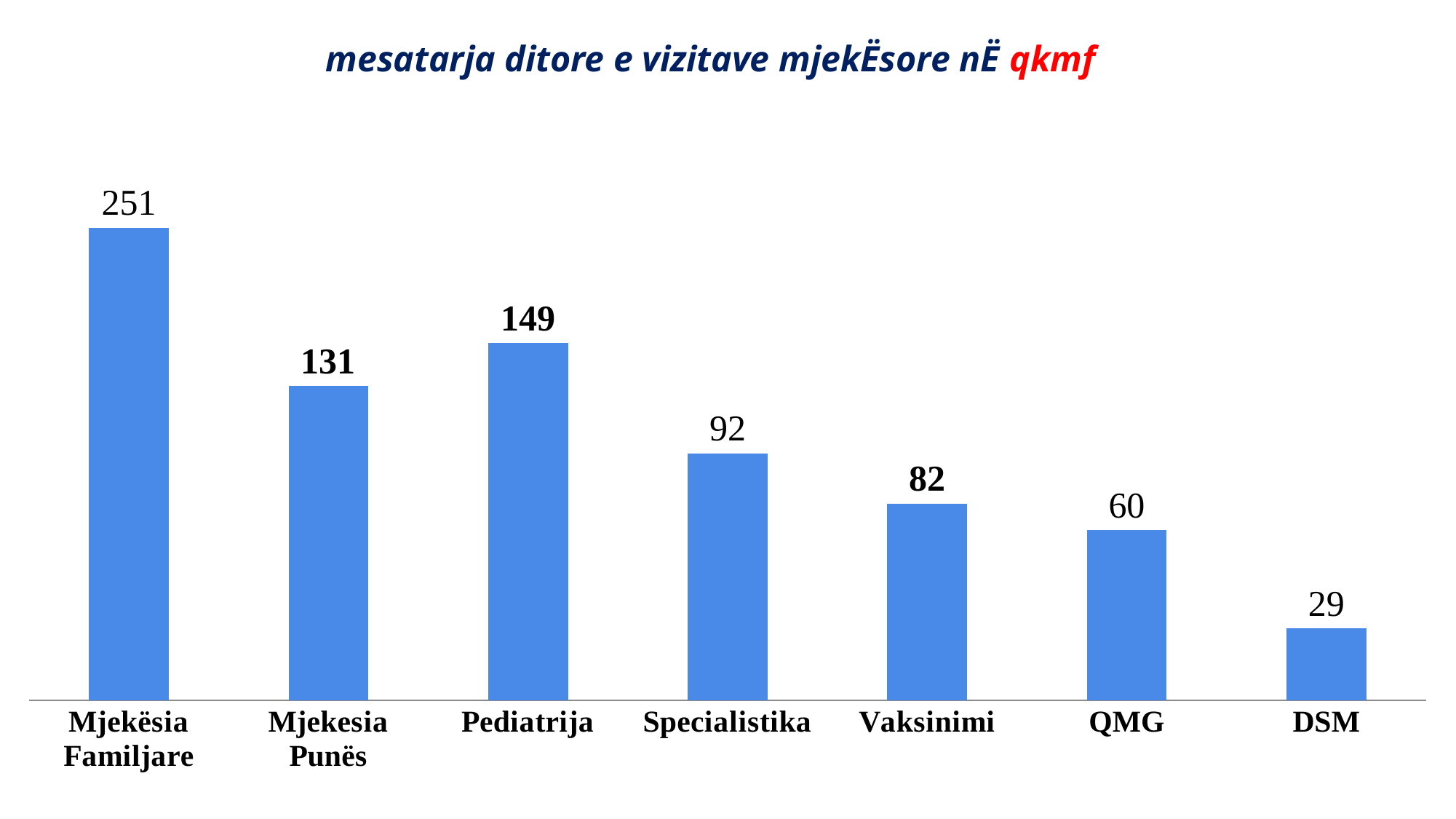
What is the difference between the values for Mjekësia Familjare and Pediatrija? 102 What is the value for Pediatrija? 149 Which category has the lowest value? DSM What kind of chart is shown on the slide? Bar chart What is the value for Mjekësia Familjare? 251 What is the difference between the values for Specialistika and QMG? 32 What is the value for Vaksinimi? 82 What is the title of the chart? mesatarja ditore e vizitave mjekËsore nË qkmf What is the value for DSM? 29 How many categories are shown on the chart? 7 Which is larger, the value for Mjekesia Punës or the value for Pediatrija? Pediatrija Which category has the highest value? Mjekësia Familjare